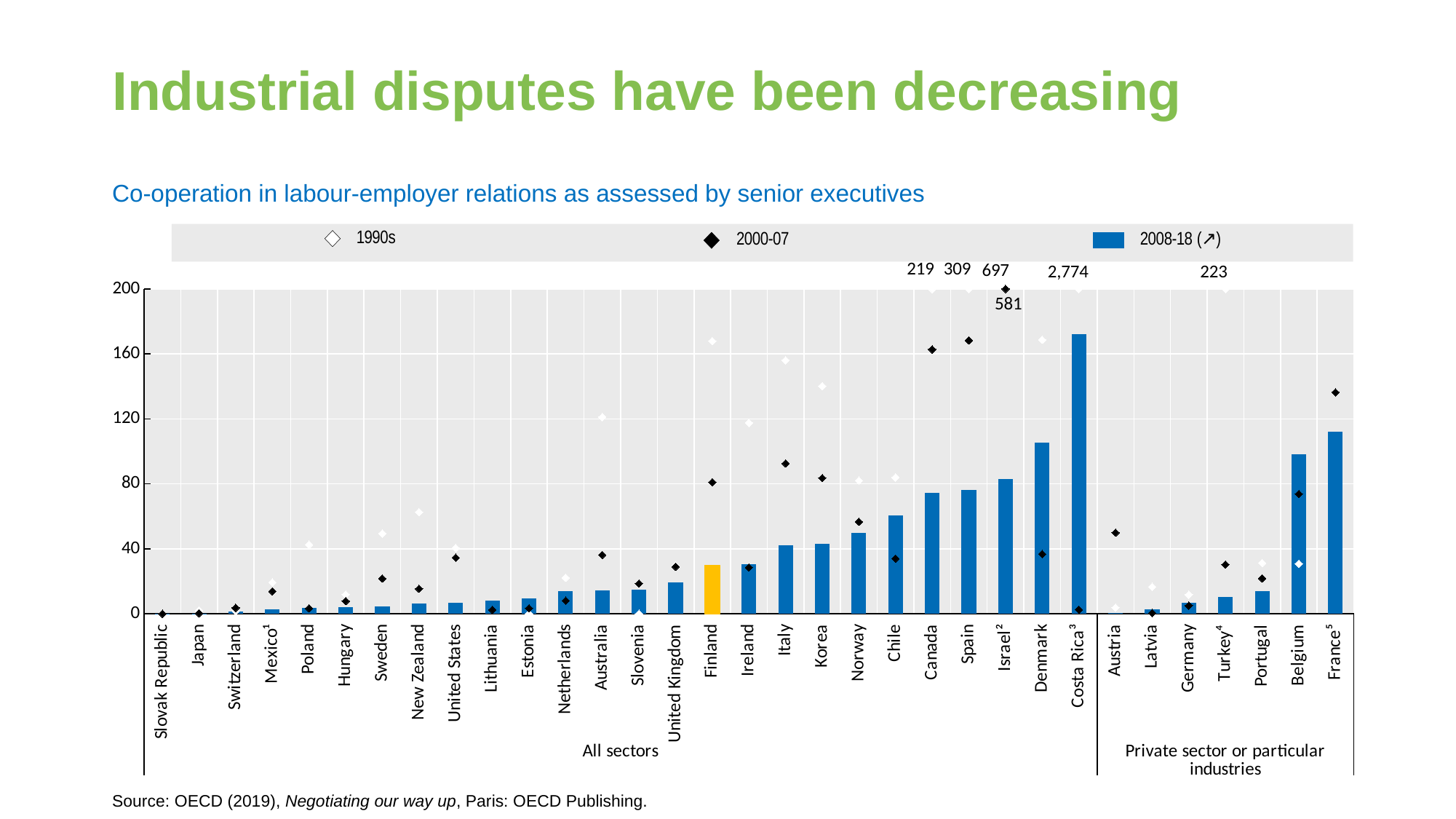
Is the 2008-18 bar for Denmark greater or less than 80? greater How many series does the legend list? 3 What is the printed 1990s value for Costa Rica? 2,774 What kind of chart is shown on the slide? bar chart What is the printed 2000-07 value for Israel? 581 Which country has the tallest 2008-18 bar? Costa Rica Is the 2008-18 bar for Italy greater or less than 80? less Which has the larger 2008-18 bar, Belgium or Portugal? Belgium What is the difference between Israel's 1990s value (697) and its 2000-07 value (581)? 116 What is the printed 1990s value for Spain? 309 How many countries are shown on the x axis in total? 33 Which country's bar is highlighted in yellow? Finland